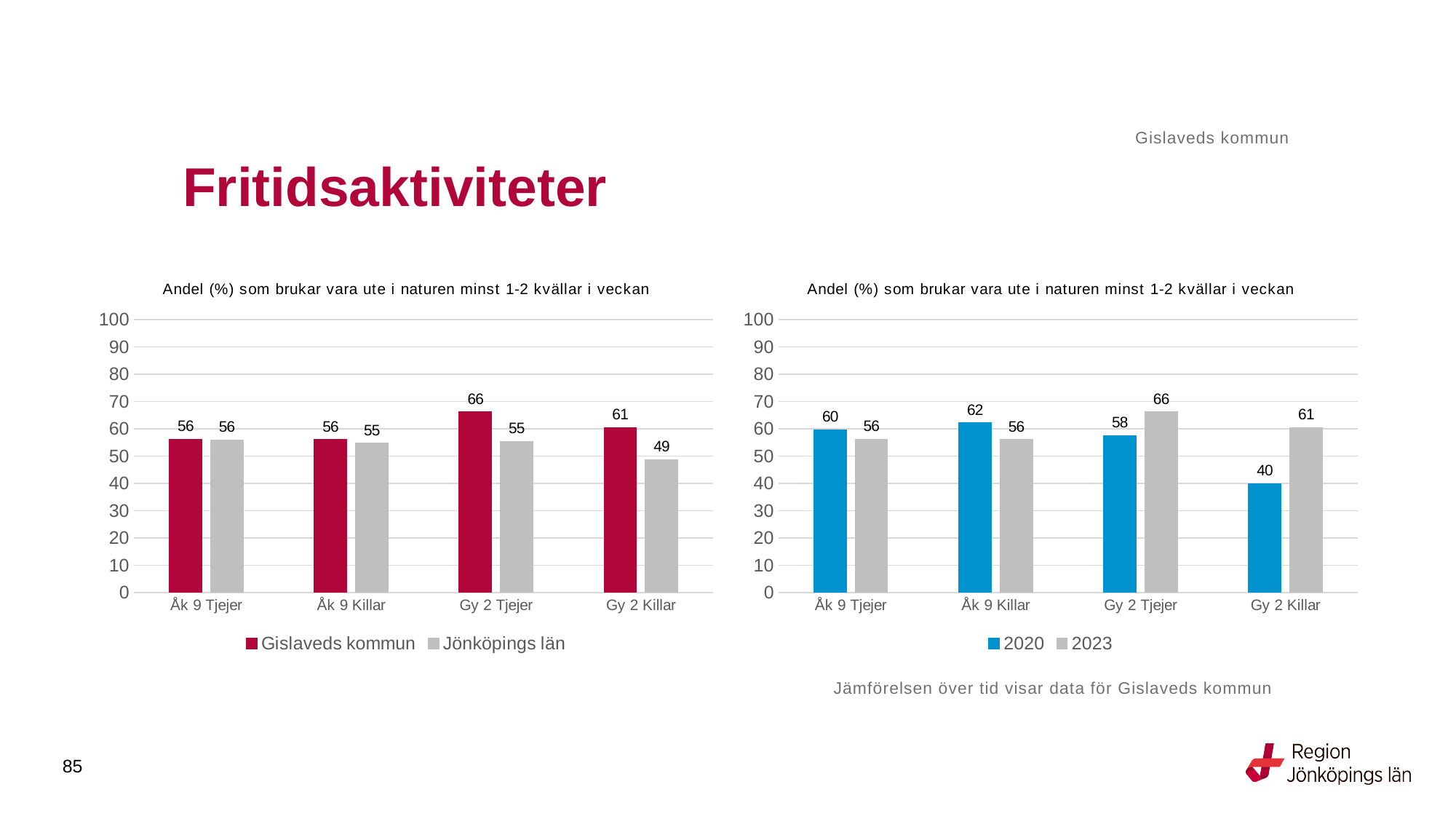
In the right chart, what is the difference between 2023 and 2020 for Gy 2 Killar? 21 How many categories are shown on the x axis of the right chart? 4 In the left chart, what is the value for Gislaveds kommun for Gy 2 Tjejer? 66 In the right chart, what is the value for 2020 for Gy 2 Killar? 40 In the left chart, how many series does the legend list? 2 In the right chart, which category has the highest value for 2020? Åk 9 Killar In the right chart, what is the value for 2023 for Gy 2 Tjejer? 66 In the right chart, which is larger for Åk 9 Tjejer: 2020 or 2023? 2020 What kind of chart is the left chart? Bar chart In the left chart, which category has the lowest value for Jönköpings län? Gy 2 Killar In the left chart, what is the difference between Gislaveds kommun and Jönköpings län for Gy 2 Killar? 12 In the left chart, what is the value for Jönköpings län for Gy 2 Killar? 49